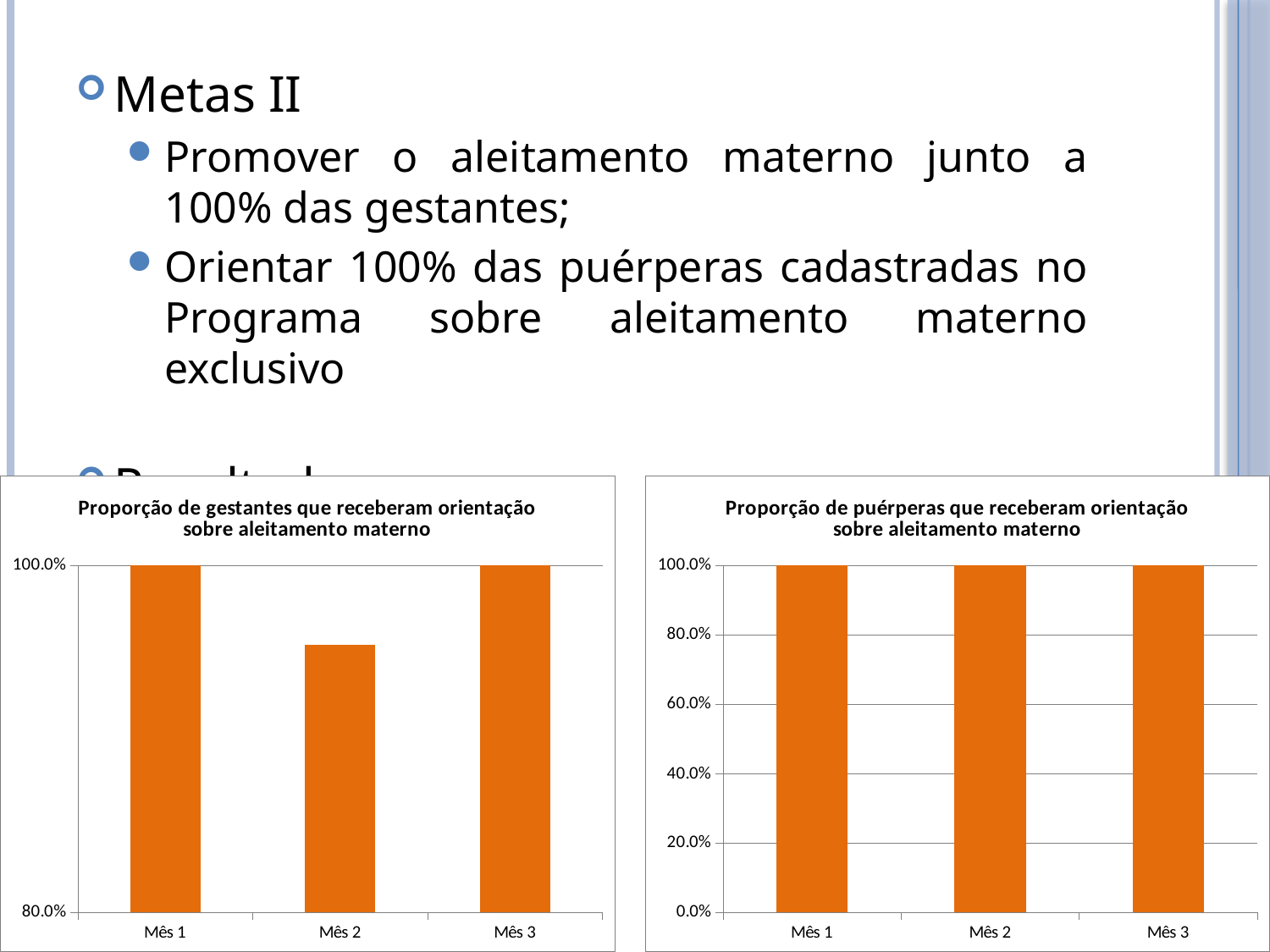
What is the title of the right chart on the slide? Proporção de puérperas que receberam orientação sobre aleitamento materno In the left chart (Proporção de gestantes que receberam orientação sobre aleitamento materno), is the value for Mês 2 greater or less than 80.0%? greater In the right chart (Proporção de puérperas que receberam orientação sobre aleitamento materno), what is the value for Mês 2? 100.0% What kind of chart is the left chart (Proporção de gestantes que receberam orientação sobre aleitamento materno)? bar chart In the right chart (Proporção de puérperas que receberam orientação sobre aleitamento materno), what is the value for Mês 3? 100.0% In the left chart (Proporção de gestantes que receberam orientação sobre aleitamento materno), is the value for Mês 2 greater or less than 100.0%? less In the left chart (Proporção de gestantes que receberam orientação sobre aleitamento materno), what is the value for Mês 1? 100.0% In the left chart (Proporção de gestantes que receberam orientação sobre aleitamento materno), which month has the lowest value? Mês 2 How many months are shown on the x axis of the right chart (Proporção de puérperas que receberam orientação sobre aleitamento materno)? 3 In the right chart (Proporção de puérperas que receberam orientação sobre aleitamento materno), do the values rise, fall or stay the same from Mês 1 to Mês 3? stay the same In the left chart (Proporção de gestantes que receberam orientação sobre aleitamento materno), what is the value for Mês 3? 100.0% In the left chart (Proporção de gestantes que receberam orientação sobre aleitamento materno), which is larger, the value for Mês 1 or Mês 2? Mês 1